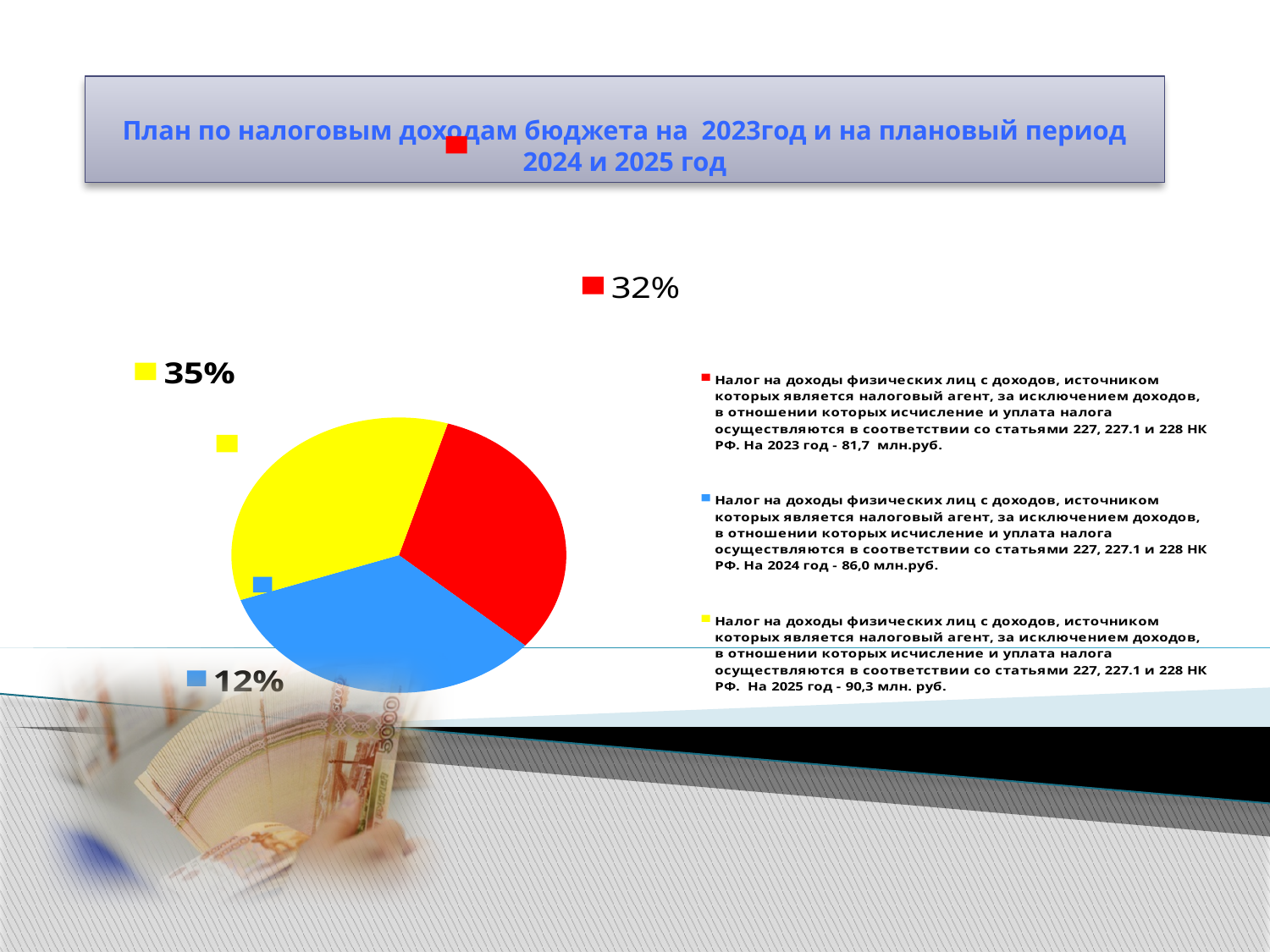
Which slice has the larger printed percentage label, the red slice or the yellow slice? yellow What percentage label is shown for the blue slice of the pie chart? 12% What percentage label is shown for the slice corresponding to the 2023 year (red legend entry)? 32% What percentage label is shown for the yellow slice of the pie chart? 35% How many slices does the pie chart have? 3 According to the legend, what planned amount in million rubles is given for 2024? 86,0 млн.руб. What is the difference between the printed labels of the yellow slice and the red slice? 3% What kind of chart is shown on the slide? pie chart What percentage label is shown for the red slice of the pie chart? 32% Which colour in the legend corresponds to the 2025 year entry? yellow How many entries does the legend of the pie chart list? 3 What percentage label is shown for the slice corresponding to the 2025 year (yellow legend entry)? 35%